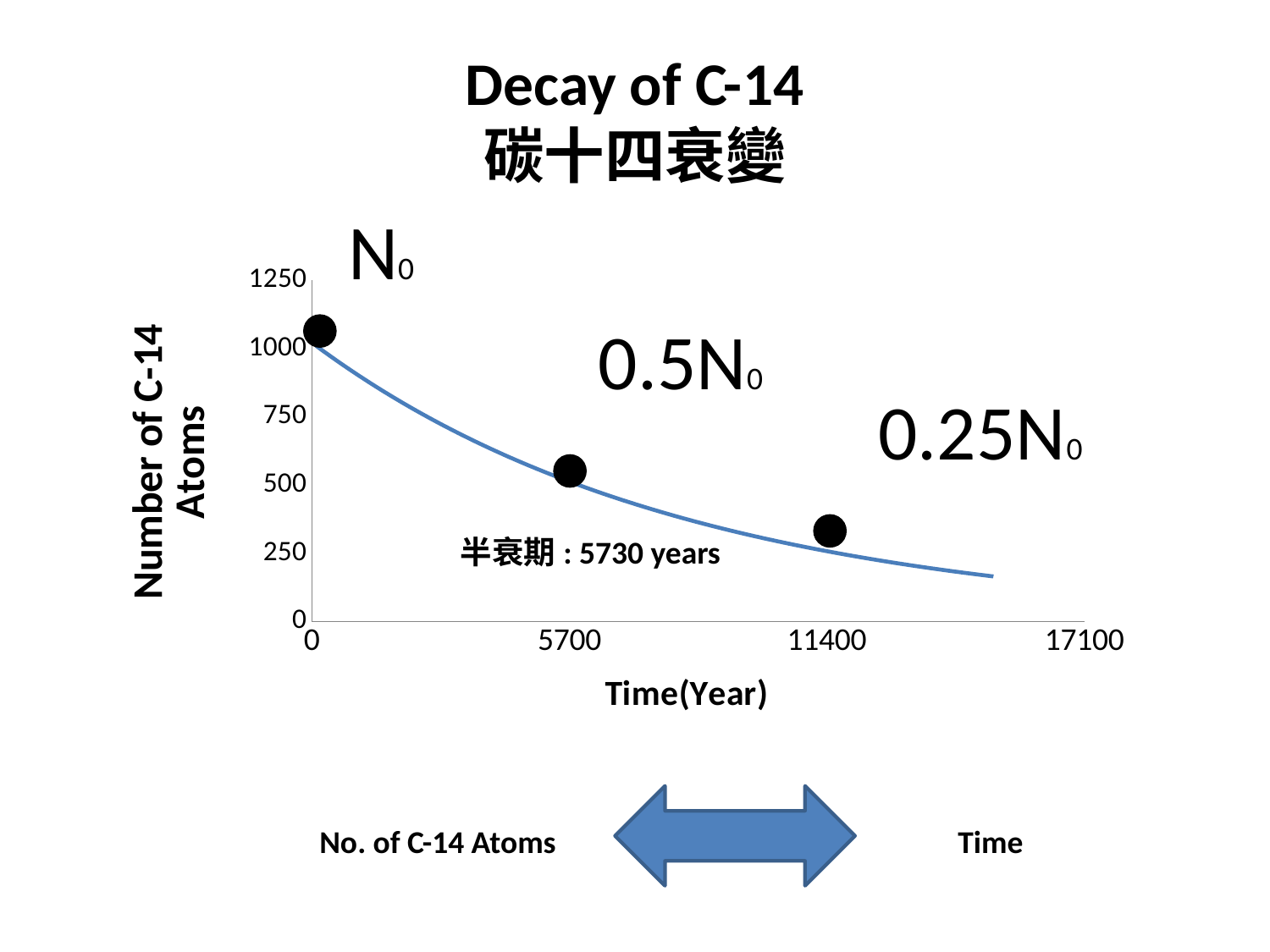
Is the number of C-14 atoms at year 5700 greater or less than 750? less Which has more C-14 atoms, the point at year 0 or the point at year 11400? year 0 What is the title of the chart? Decay of C-14 At which time (year) is the number of C-14 atoms highest? 0 Is the number of C-14 atoms at year 11400 greater or less than 500? less Is the number of C-14 atoms at year 0 greater or less than 750? greater What kind of chart is shown on the slide? line chart Do the values rise or fall as time increases along the x axis? fall What is the label of the x axis? Time(Year)